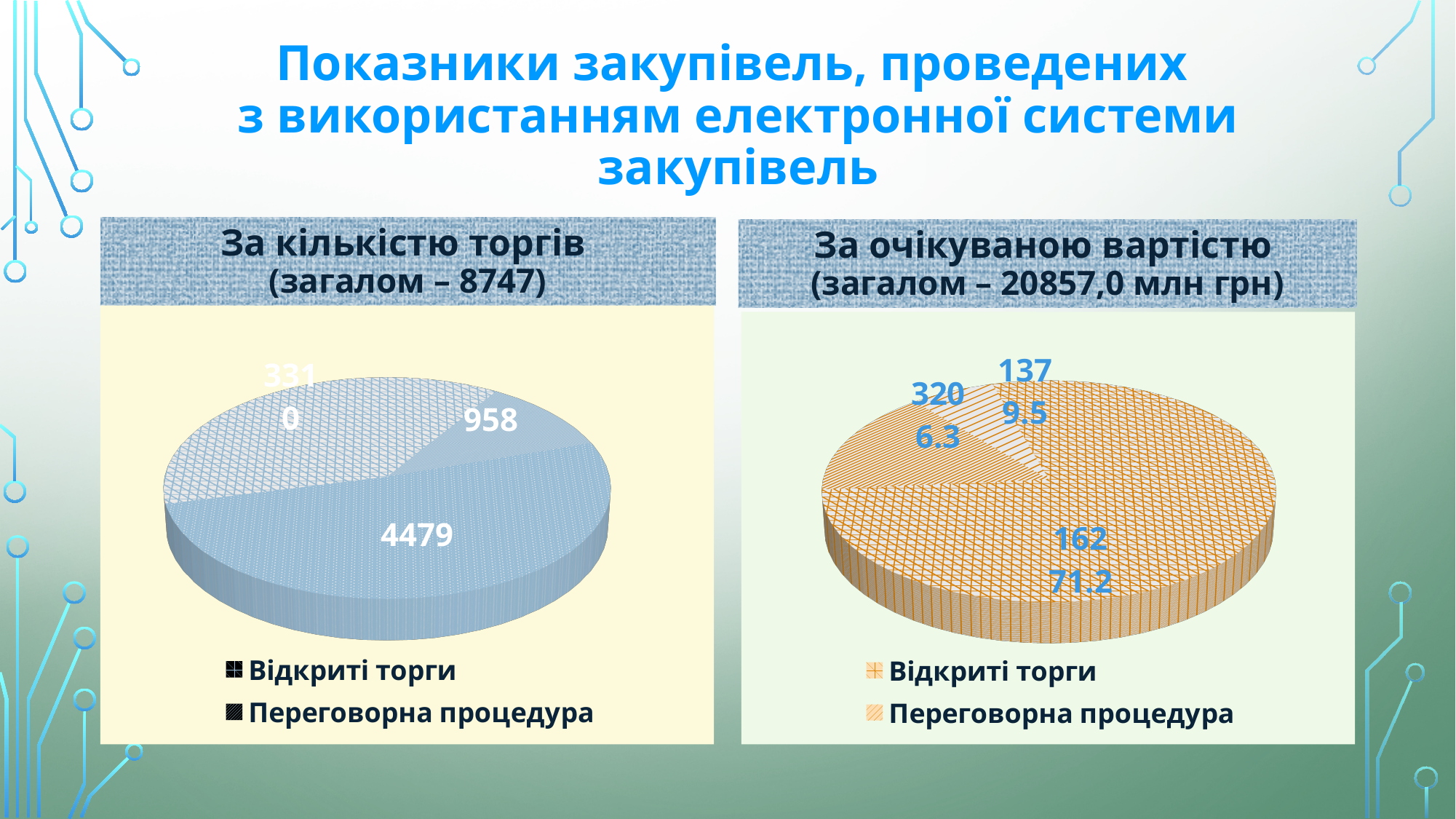
In the chart "За кількістю торгів", what is the value of the largest slice? 4479 In the chart "За кількістю торгів", what is the value of the smallest slice? 958 How many slices does the chart "За кількістю торгів" have? 3 In the chart "За очікуваною вартістю", which is larger: the slice labelled 3206.3 or the slice labelled 1379.5? 3206.3 What kind of chart is shown under the heading "За кількістю торгів"? pie chart In the chart "За очікуваною вартістю", what is the value of the largest slice? 16271.2 In the chart "За очікуваною вартістю", what is the value of the smallest slice? 1379.5 What total is stated in the heading of the chart "За кількістю торгів"? 8747 In the chart "За кількістю торгів", what is the difference between the largest slice (4479) and the smallest slice (958)? 3521 What total is stated in the heading of the chart "За очікуваною вартістю"? 20857,0 млн грн How many entries does the legend of the chart "За очікуваною вартістю" list? 2 What kind of chart is shown under the heading "За очікуваною вартістю"? pie chart